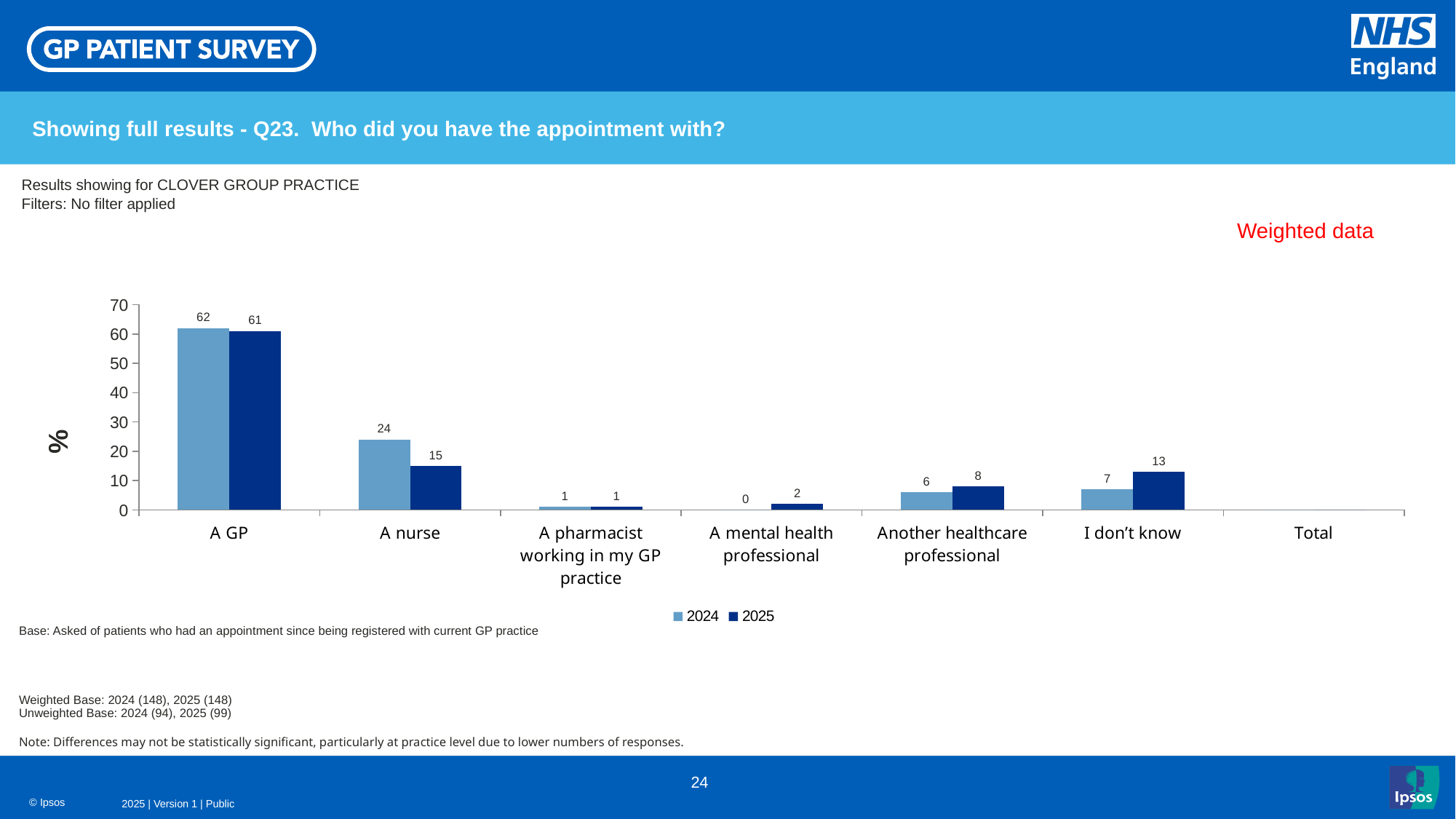
What kind of chart is shown on the slide? Bar chart What is the 2024 value for 'A mental health professional'? 0 What is the 2024 value for 'A GP'? 62 What is the 2025 value for 'A nurse'? 15 What is the 2025 value for 'I don't know'? 13 Which category has the lowest 2024 value? A mental health professional Which category has the highest 2025 value? A GP What is the difference between the 2024 and 2025 values for 'A nurse'? 9 Is the 2024 value for 'A GP' greater or less than 50? greater Which is larger for 'Another healthcare professional': the 2024 value or the 2025 value? 2025 How many series does the legend list? 2 What are the two series listed in the legend? 2024 and 2025